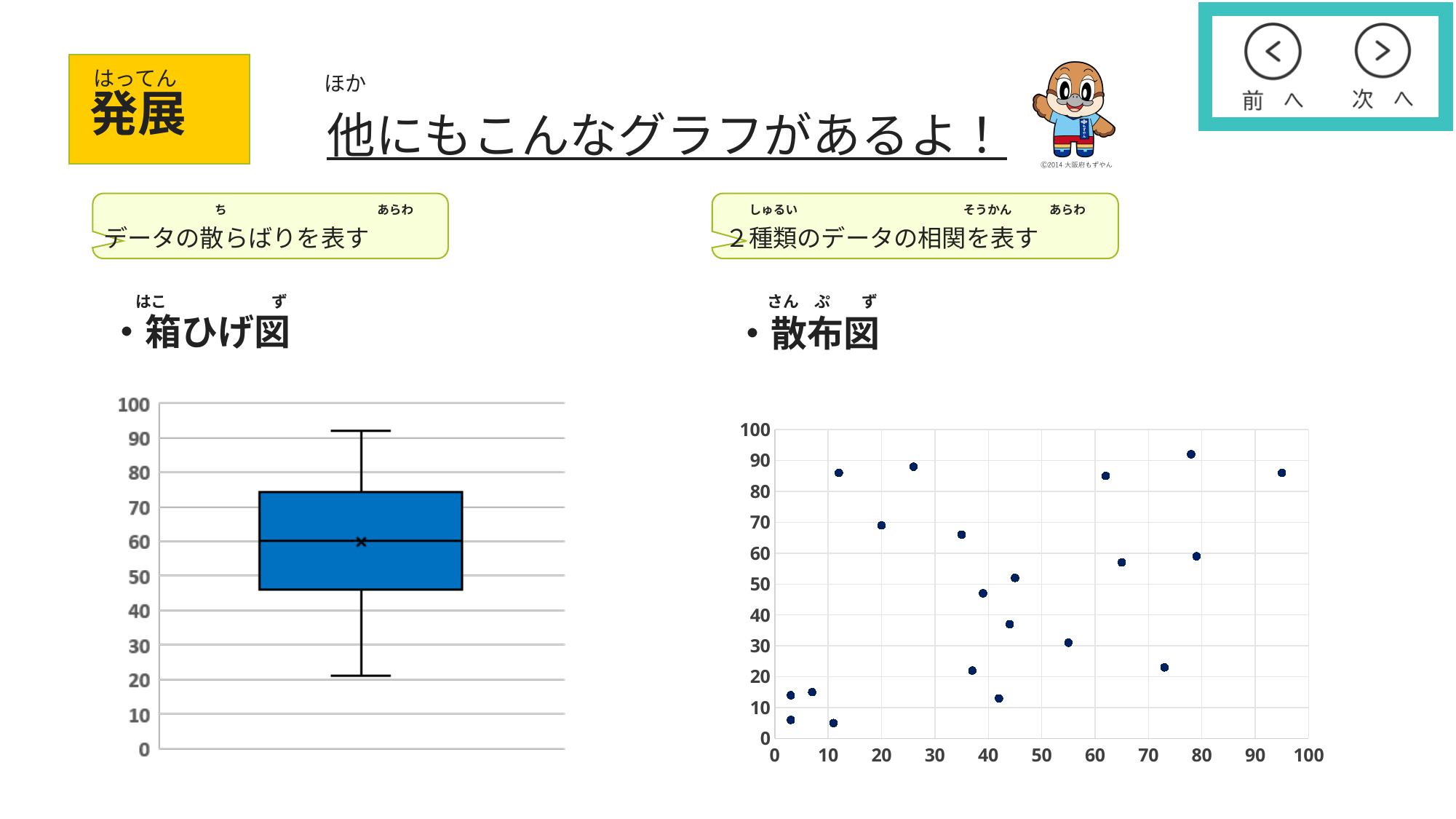
In the scatter plot on the right, is the y value of the lowest point greater or less than 10? less How many data points are plotted in the scatter plot on the right? 20 In the scatter plot on the right, is the y value of the highest point greater or less than 80? greater In the box plot on the left, is the bottom of the lower whisker (the minimum) greater or less than 30? less What is the highest value shown on the vertical axis of the box plot on the left? 100 What kind of chart is the chart on the left side of the slide (箱ひげ図)? box plot What kind of chart is the chart on the right side of the slide (散布図)? scatter plot